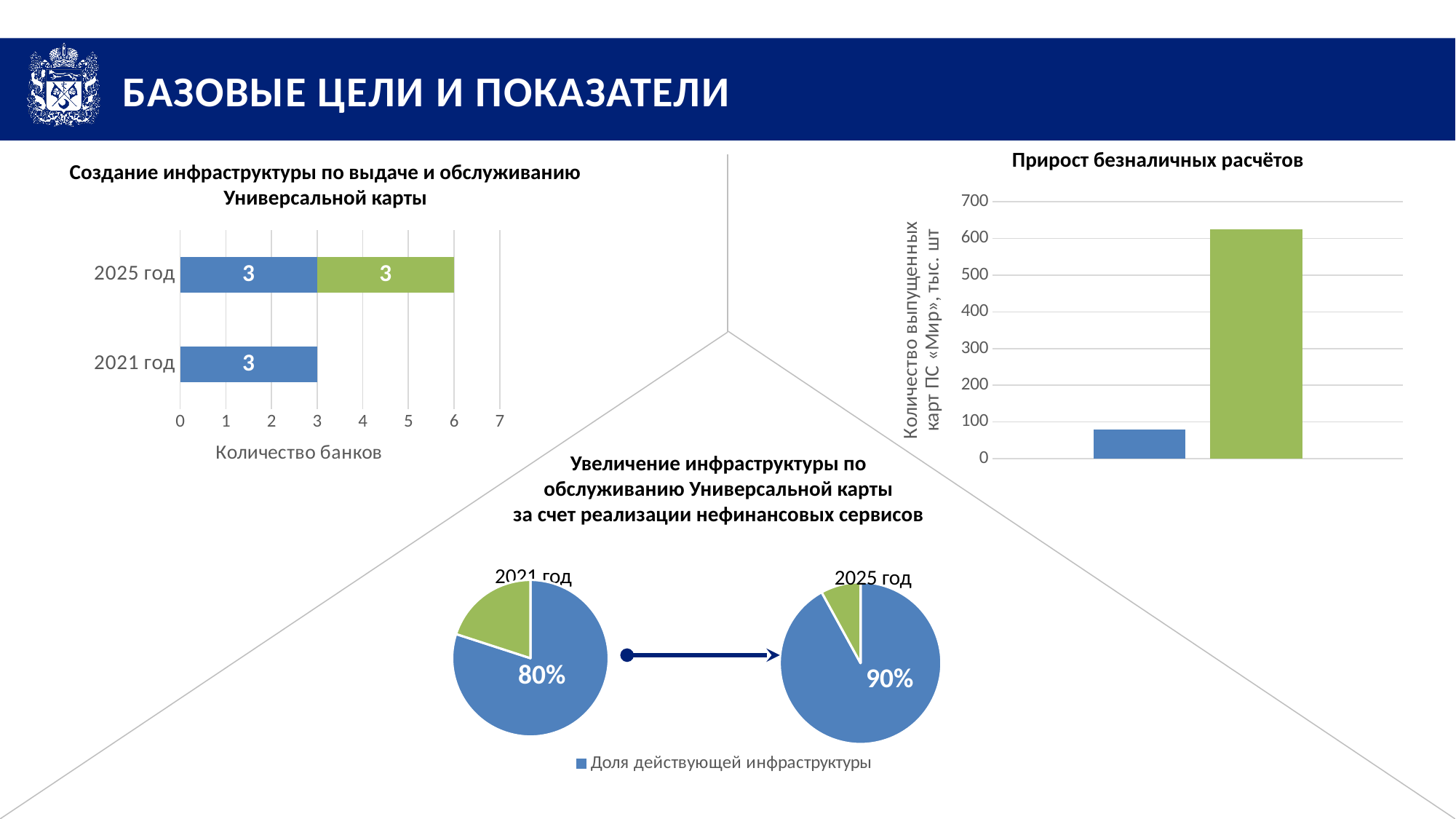
In the top-left chart «Создание инфраструктуры по выдаче и обслуживанию Универсальной карты», how many year categories are shown? 2 In the top-left chart «Создание инфраструктуры по выдаче и обслуживанию Универсальной карты», what is the value for 2021 год? 3 In the top-left chart «Создание инфраструктуры по выдаче и обслуживанию Универсальной карты», what is the total of the stacked bar for 2025 год? 6 What kind of chart is the top-right chart titled «Прирост безналичных расчётов»? bar chart What kind of chart is the top-left chart titled «Создание инфраструктуры по выдаче и обслуживанию Универсальной карты»? bar chart In the bottom pie charts «Увеличение инфраструктуры по обслуживанию Универсальной карты за счет реализации нефинансовых сервисов», what share does the blue slice have in the 2021 год pie? 80% In the top-right chart «Прирост безналичных расчётов», is the value of the green bar greater or less than 500? greater In the top-right chart «Прирост безналичных расчётов», how many bars are plotted? 2 In the top-right chart «Прирост безналичных расчётов», is the value of the blue bar greater or less than 100? less In the top-right chart «Прирост безналичных расчётов», which bar is larger, the blue bar or the green bar? the green bar In the bottom pie charts «Увеличение инфраструктуры по обслуживанию Универсальной карты за счет реализации нефинансовых сервисов», what share does the blue slice have in the 2025 год pie? 90% In the top-left chart «Создание инфраструктуры по выдаче и обслуживанию Универсальной карты», what is the x-axis title? Количество банков